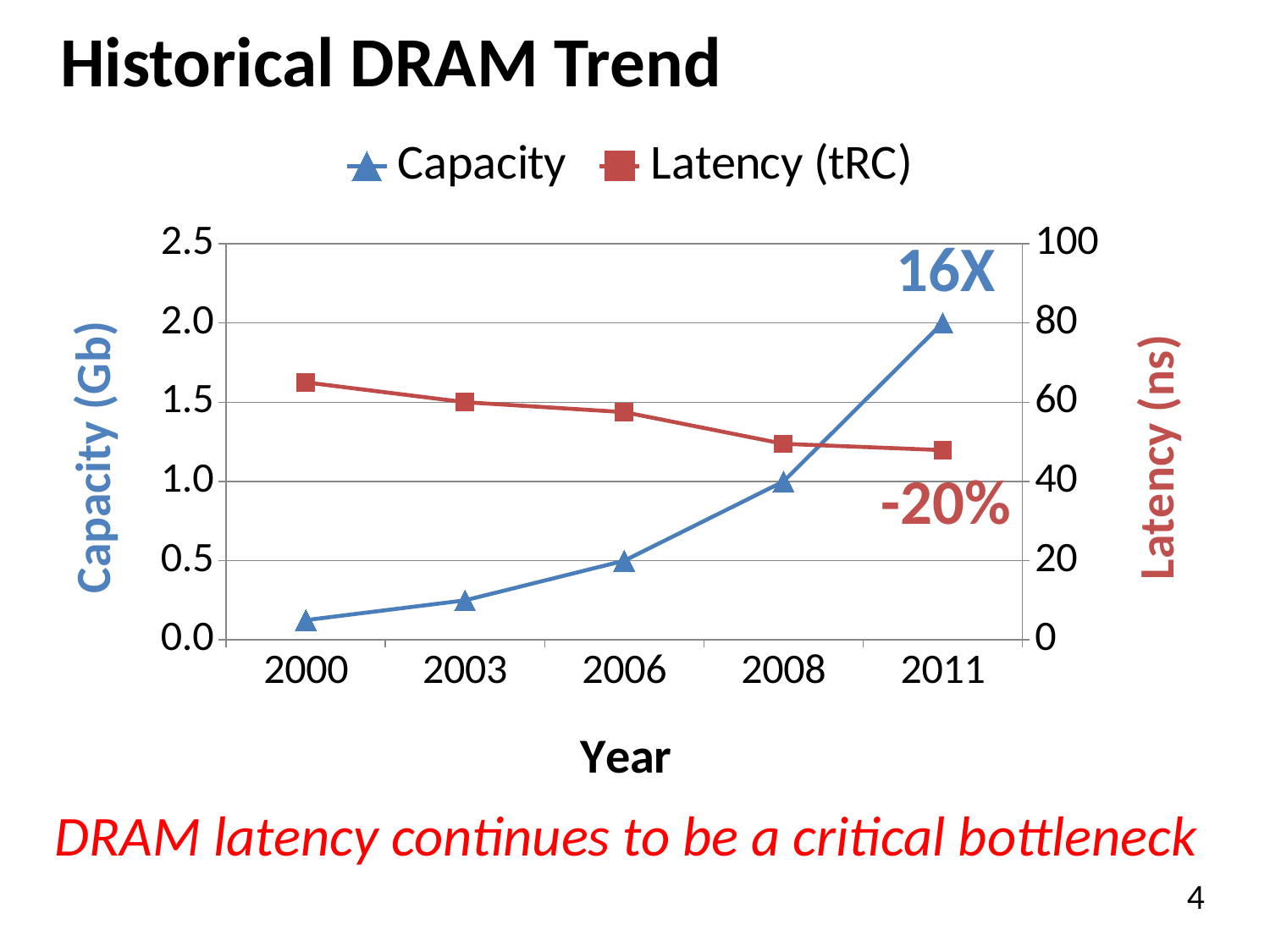
What annotation is printed next to the Capacity series at 2011? 16X How many years are plotted along the x axis? 5 What is the Capacity value in 2011? 2.0 What is the Capacity value in 2008? 1.0 How many series does the legend list? 2 Is the Latency (tRC) value in 2000 greater or less than 60? greater Does the Capacity series rise or fall from 2000 to 2011? rise In which year is Latency (tRC) highest? 2000 Is the Capacity value in 2000 greater or less than 0.5? less Does the Latency (tRC) series rise or fall from 2000 to 2011? fall In which year is Capacity highest? 2011 What kind of chart is shown on the slide? line chart